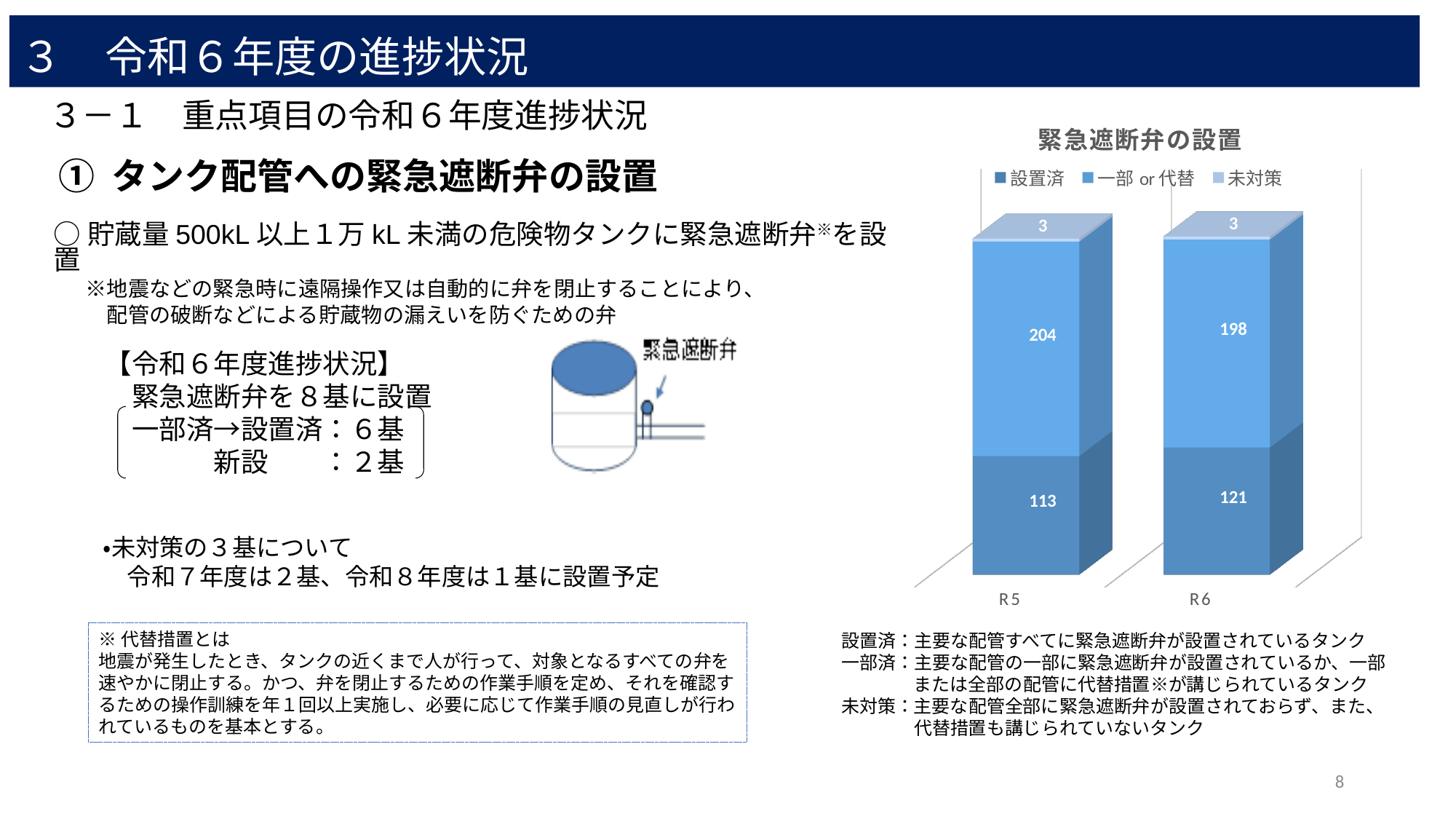
What is the difference between the 設置済 values for R6 and R5? 8 What is the value for 一部 or 代替 in R6? 198 Which year has the larger 設置済 value, R5 or R6? R6 How many series does the legend list? 3 What is the value for 設置済 in R5? 113 What is the difference between the 一部 or 代替 values for R5 and R6? 6 Which year has the larger 一部 or 代替 value, R5 or R6? R5 What kind of chart is shown on the slide? Stacked bar chart What is the total of the stacked bar for R6? 320 What is the value for 設置済 in R6? 121 What is the value for 未対策 in R5? 3 What is the total of the stacked bar for R5? 320